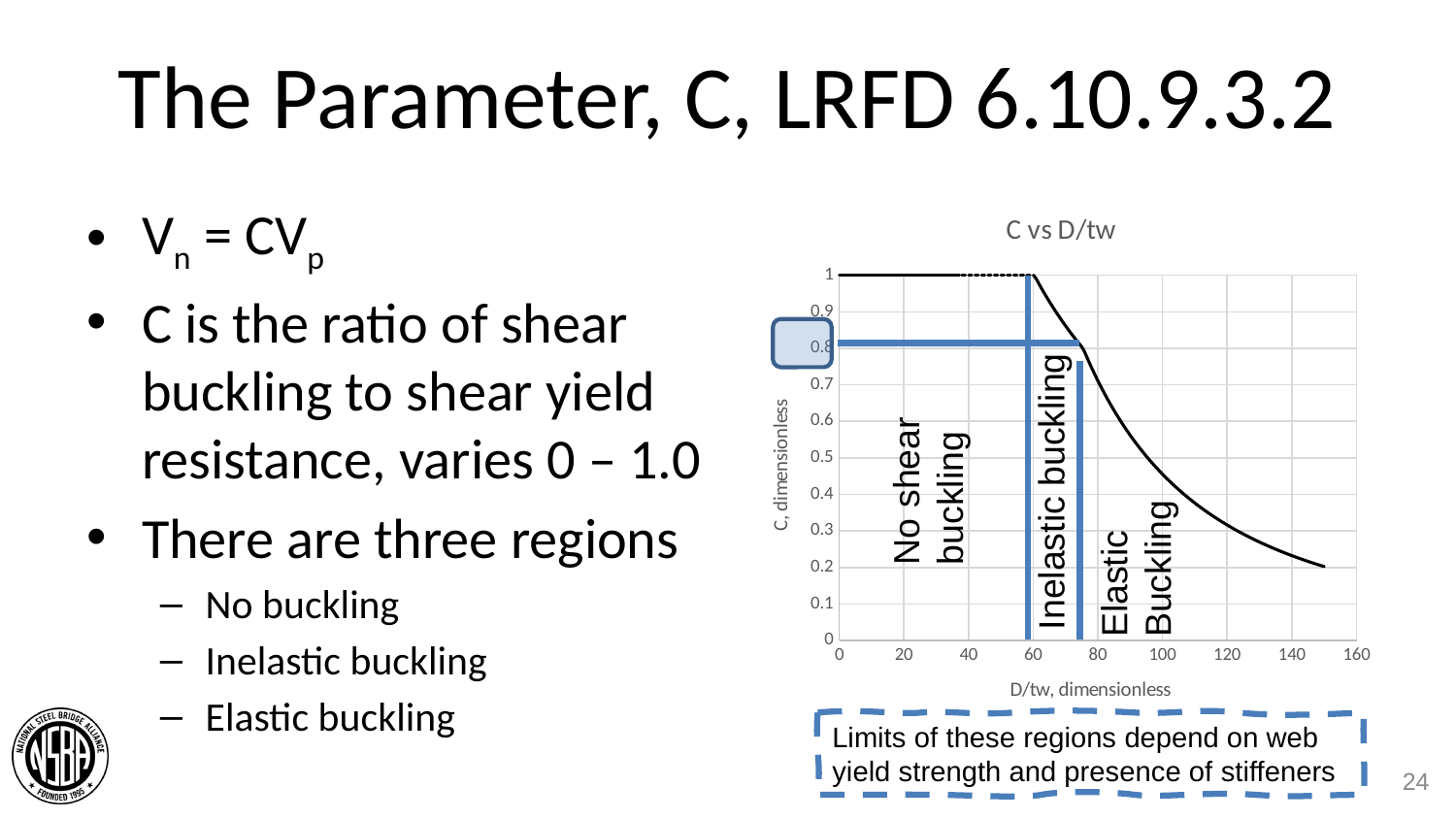
Which is larger, the value of C at D/tw = 20 or at D/tw = 100? D/tw = 20 What is the label of the x axis of the chart? D/tw, dimensionless Is the value of C at D/tw = 140 greater or less than 0.3? less What is the highest tick value shown on the x axis? 160 Is the value of C at D/tw = 120 greater or less than 0.4? less Is the value of C at D/tw = 40 greater or less than 0.9? greater What kind of chart is shown on the slide? line chart What is the title of the chart? C vs D/tw Does the value of C rise or fall as D/tw increases beyond 60? fall How many buckling regions are marked on the chart? 3 Which region is marked at the highest values of D/tw on the chart? Elastic Buckling